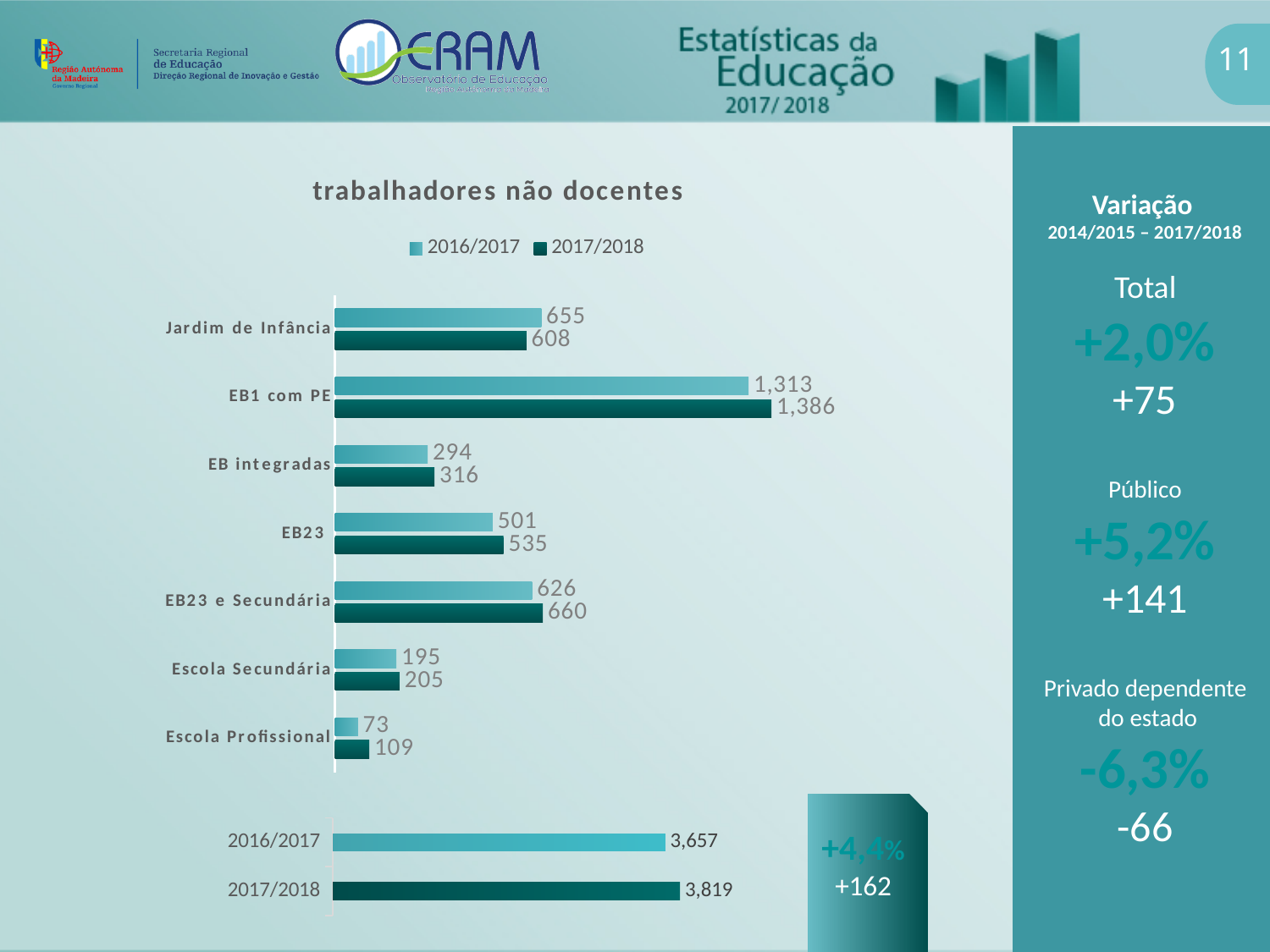
In the small chart at the bottom of the slide, what is the difference between the 2017/2018 and 2016/2017 values? 162 How many categories are shown in the 'trabalhadores não docentes' chart? 7 In the 'trabalhadores não docentes' chart, which category has the highest value for 2017/2018? EB1 com PE In the 'trabalhadores não docentes' chart, what is the value for EB1 com PE in 2017/2018? 1,386 In the 'trabalhadores não docentes' chart, what is the difference between the 2016/2017 and 2017/2018 values for Jardim de Infância? 47 In the 'trabalhadores não docentes' chart, which category has the lowest value for 2016/2017? Escola Profissional What kind of chart is the 'trabalhadores não docentes' chart? Bar chart In the 'trabalhadores não docentes' chart, for Jardim de Infância, which year has the larger value, 2016/2017 or 2017/2018? 2016/2017 In the 'trabalhadores não docentes' chart, what is the value for Escola Profissional in 2016/2017? 73 In the small chart at the bottom of the slide, what is the value for 2017/2018? 3,819 How many series does the legend of the 'trabalhadores não docentes' chart list? 2 What is the title of the main chart on the slide? trabalhadores não docentes